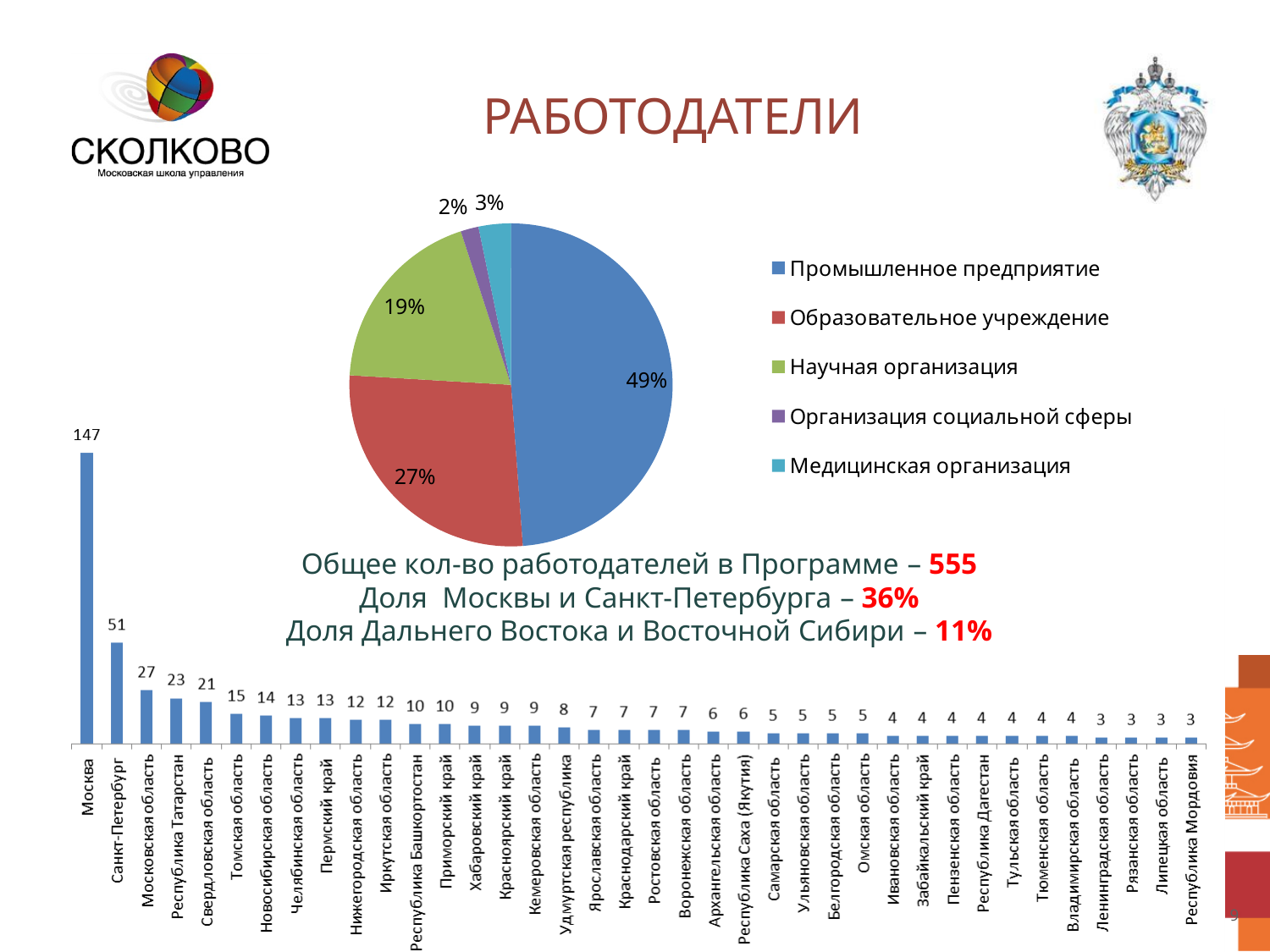
In the pie chart, what share is labelled for Образовательное учреждение? 27% In the pie chart, which category has the smallest slice? Организация социальной сферы In the pie chart, what share is labelled for Промышленное предприятие? 49% What kind of chart is the chart at the bottom of the slide showing regions? bar chart In the bar chart of regions, what is the value for Москва? 147 In the pie chart, what is the difference between the shares for Научная организация and Медицинская организация? 16% How many entries does the legend of the pie chart list? 5 In the bar chart of regions, which region has the highest value? Москва In the bar chart of regions, which is larger: the value for Московская область or the value for Свердловская область? Московская область In the bar chart of regions, what is the difference between the values for Москва and Санкт-Петербург? 96 In the bar chart of regions, what is the value for Санкт-Петербург? 51 In the bar chart of regions, what is the value for Республика Татарстан? 23